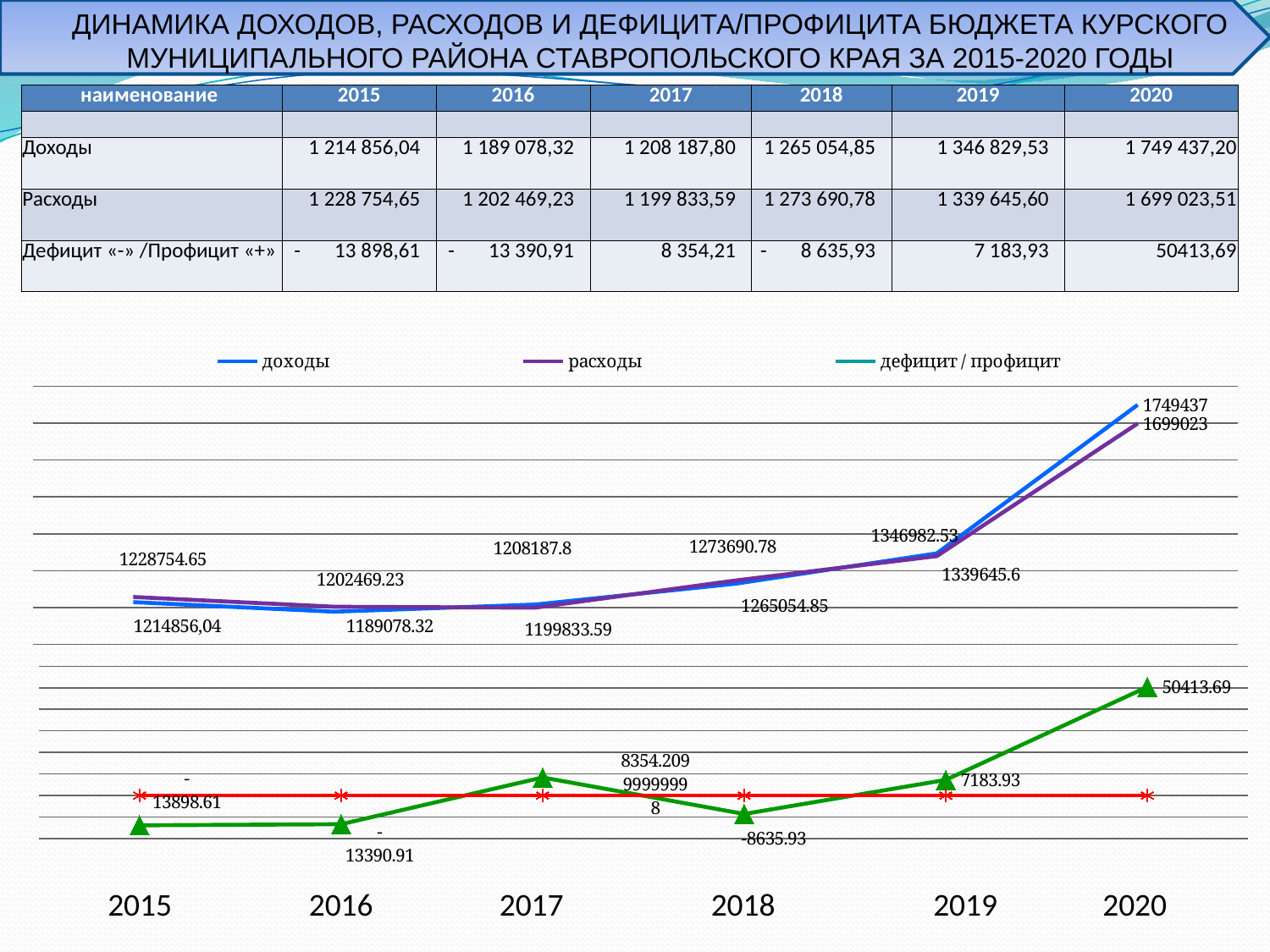
What is the value of дефицит / профицит for 2020 on the chart? 50413.69 How many years are plotted along the x axis of the chart? 6 What is the value of расходы for 2020 on the chart? 1699023 What kind of chart is shown on the slide? line chart What is the value of дефицит / профицит for 2018 on the chart? -8635.93 In which year is дефицит / профицит highest on the chart? 2020 What is the value of доходы for 2020 on the chart? 1749437 In which year is доходы highest on the chart? 2020 How many series does the chart legend list? 3 What is the value of расходы for 2015 on the chart? 1228754.65 What is the difference between the дефицит / профицит values for 2020 and 2019 on the chart? 43229.76 Which is larger in 2015 on the chart, доходы or расходы? расходы